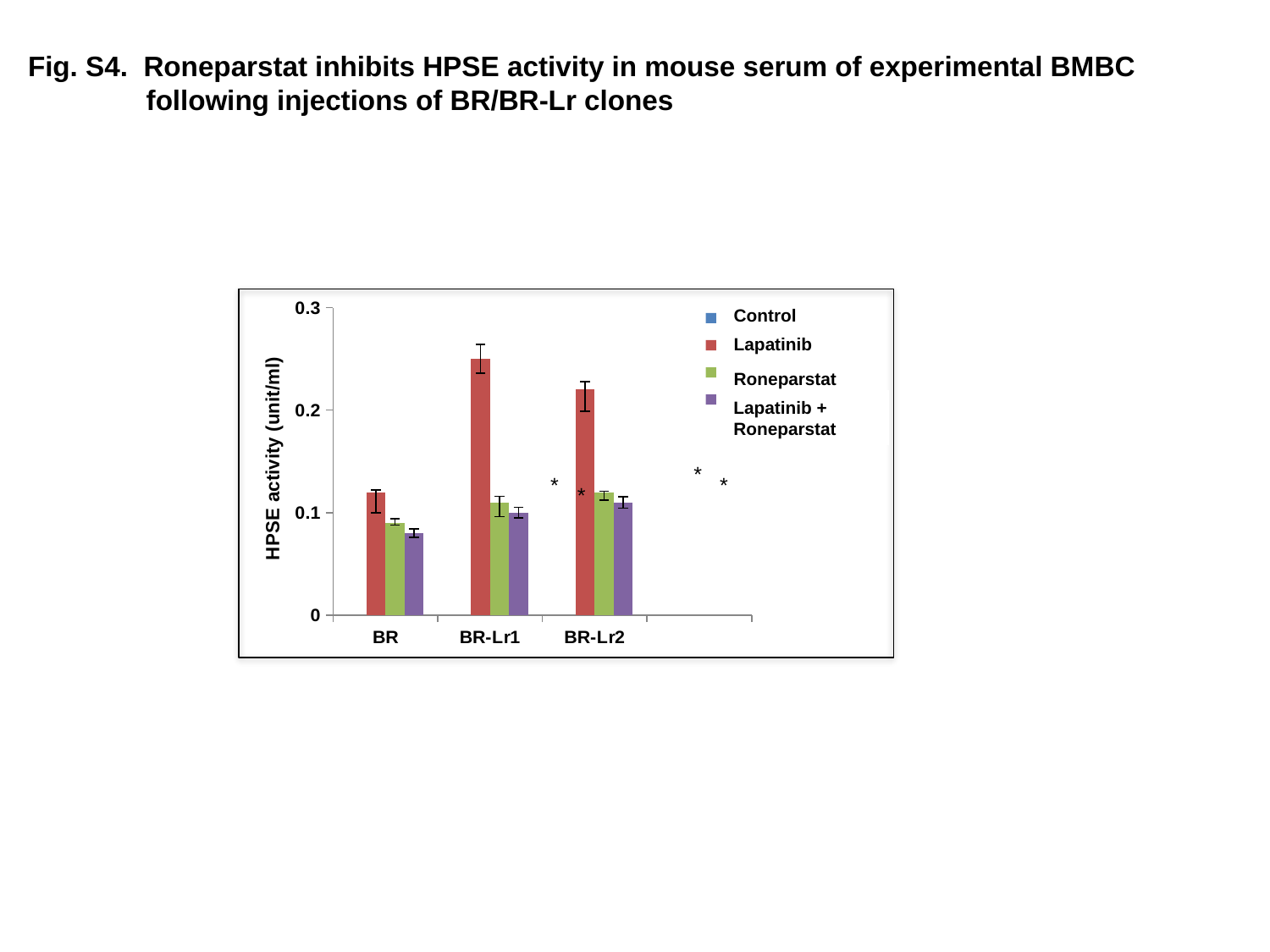
Is the Roneparstat value for BR-Lr1 greater or less than 0.2? less Which category has the lowest Lapatinib value? BR Is the Lapatinib value for BR greater or less than 0.2? less What is the y-axis title of the chart? HPSE activity (unit/ml) How many categories are shown on the x axis of the chart? 3 What kind of chart is shown on the slide? bar chart For BR-Lr1, which is larger: the Lapatinib value or the Roneparstat value? Lapatinib Which series is listed last in the chart's legend? Lapatinib + Roneparstat Is the Lapatinib + Roneparstat value for BR greater or less than 0.1? less Which category has the highest Lapatinib value? BR-Lr1 How many series does the chart's legend list? 4